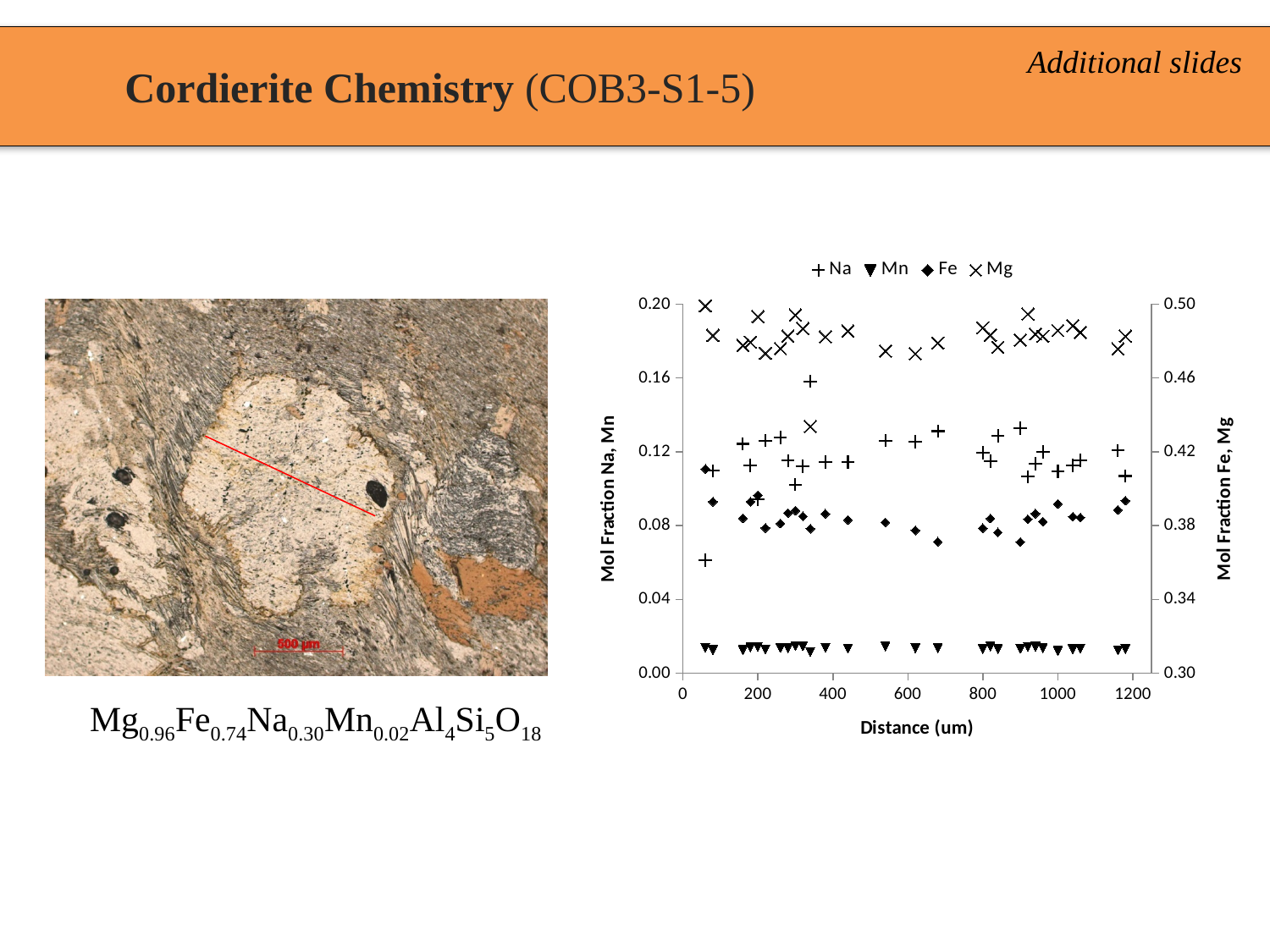
Do the Mn values show a clear rise or fall along the x axis, or stay roughly flat? Roughly flat What kind of chart is shown on the slide? Scatter chart Are the Fe values on the chart greater or less than 0.42 on the right axis? less Which series is plotted with the lowest values on the chart? Mn Which series has larger values on the chart, Na or Mn? Na Which series is plotted with the highest values on the chart? Mg Are the Mn values on the chart greater or less than 0.04 on the left axis? less How many series does the chart legend list? 4 What is the title of the left vertical axis of the chart? Mol Fraction Na, Mn Which series has larger values on the chart, Fe or Mg? Mg What is the title of the x axis of the chart? Distance (um)